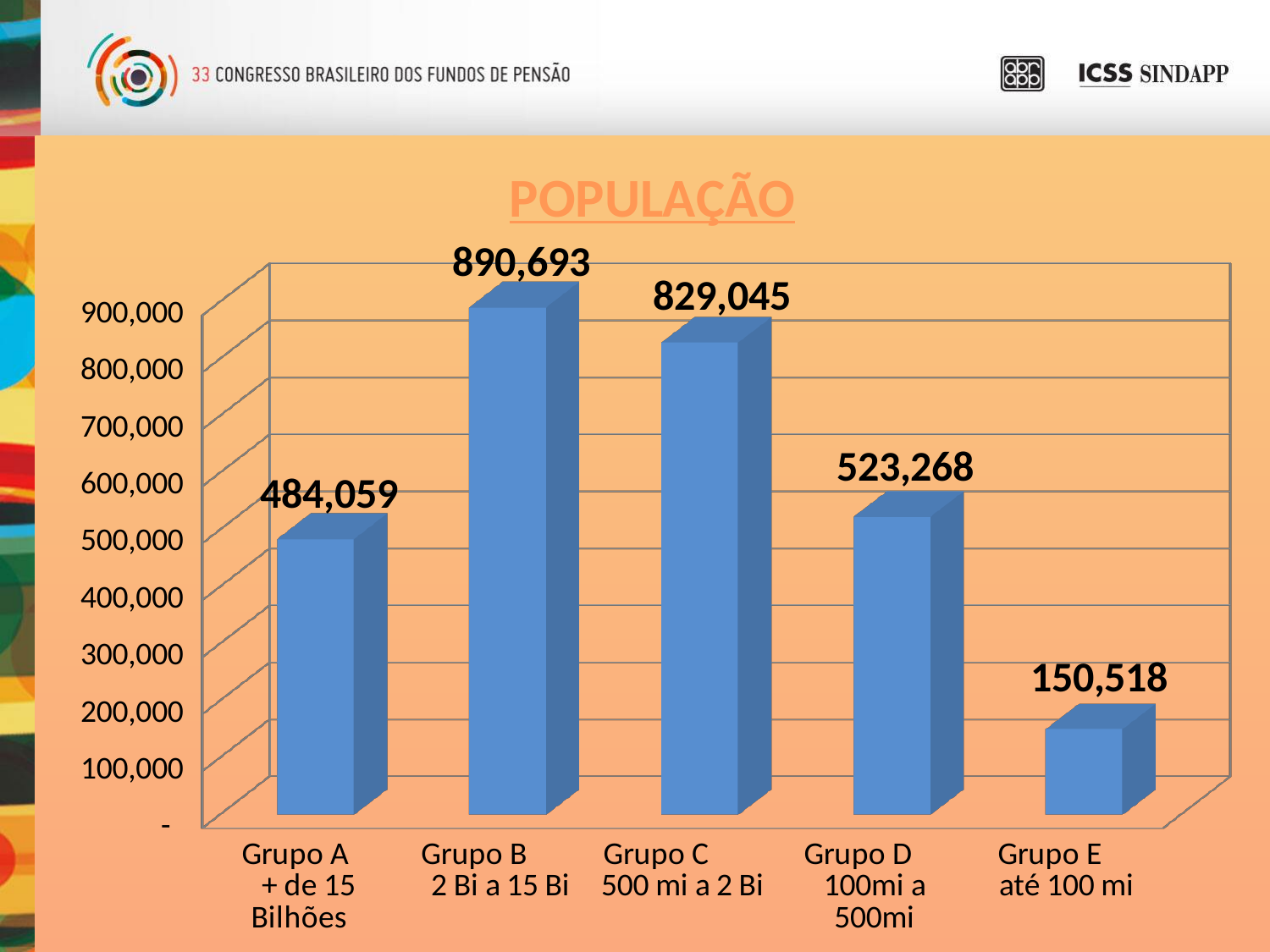
Which is larger, the value for Grupo A or the value for Grupo D? Grupo D Is the value for Grupo C greater or less than 800,000? greater What is the value for Grupo E (até 100 mi)? 150,518 What is the value for Grupo B (2 Bi a 15 Bi)? 890,693 Which group has the highest value? Grupo B What is the difference between the values for Grupo B and Grupo C? 61,648 What is the title of the chart? POPULAÇÃO What is the difference between the values for Grupo D and Grupo E? 372,750 How many groups are shown on the chart? 5 What is the value for Grupo A (+ de 15 Bilhões)? 484,059 Which group has the lowest value? Grupo E What kind of chart is shown on the slide? bar chart